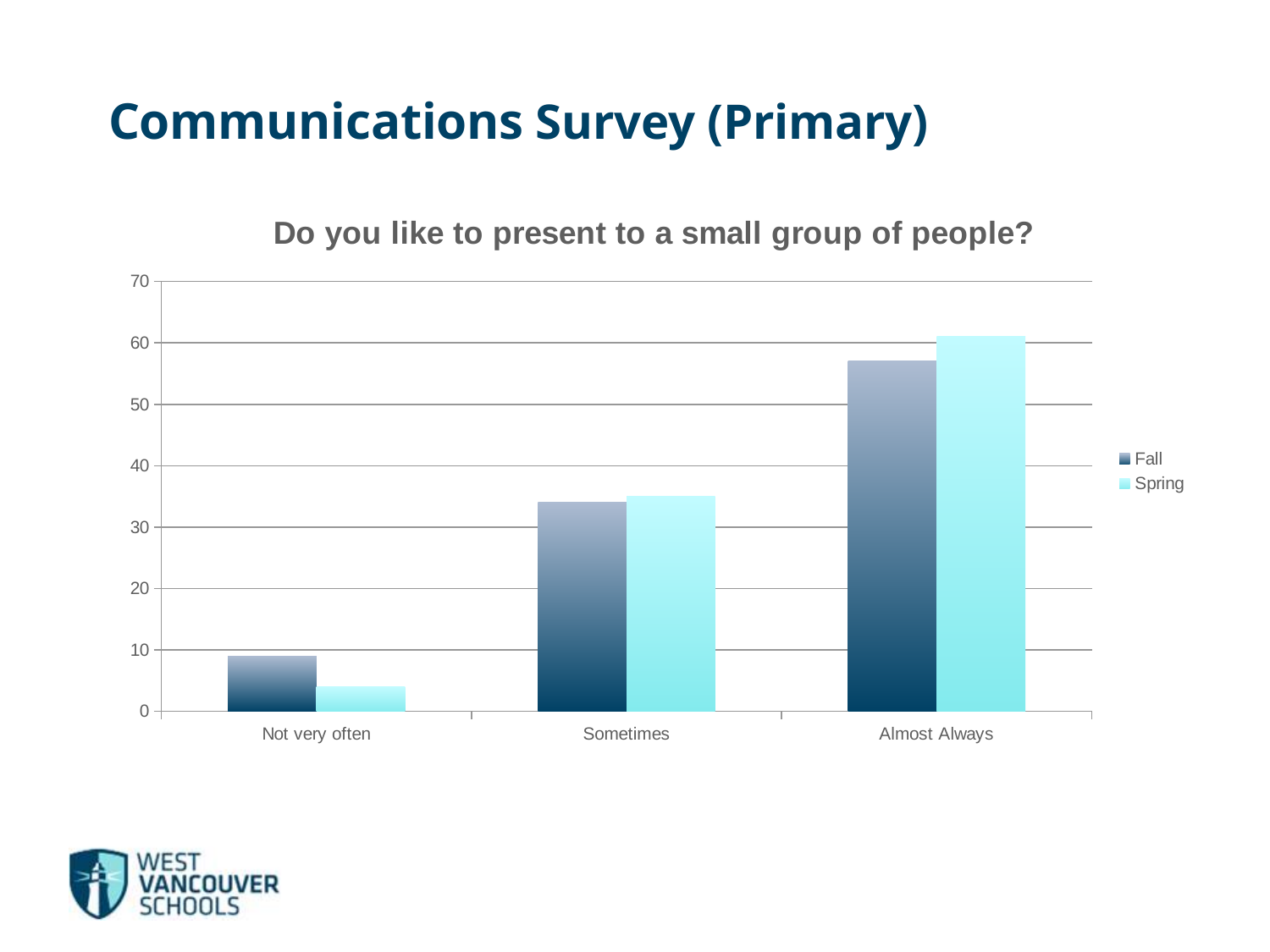
How many categories are shown on the x axis? 3 Which category has the lowest Spring value? Not very often Is the Fall value for Almost Always greater or less than 50? greater Is the Fall value for Sometimes greater or less than 30? greater Which category has the highest Fall value? Almost Always What kind of chart is shown on the slide? bar chart For Almost Always, which is larger, the Fall value or the Spring value? Spring Is the Spring value for Sometimes greater or less than 40? less What is the title of the chart? Do you like to present to a small group of people? Do the Fall values rise or fall from Not very often to Almost Always? rise How many series does the legend list? 2